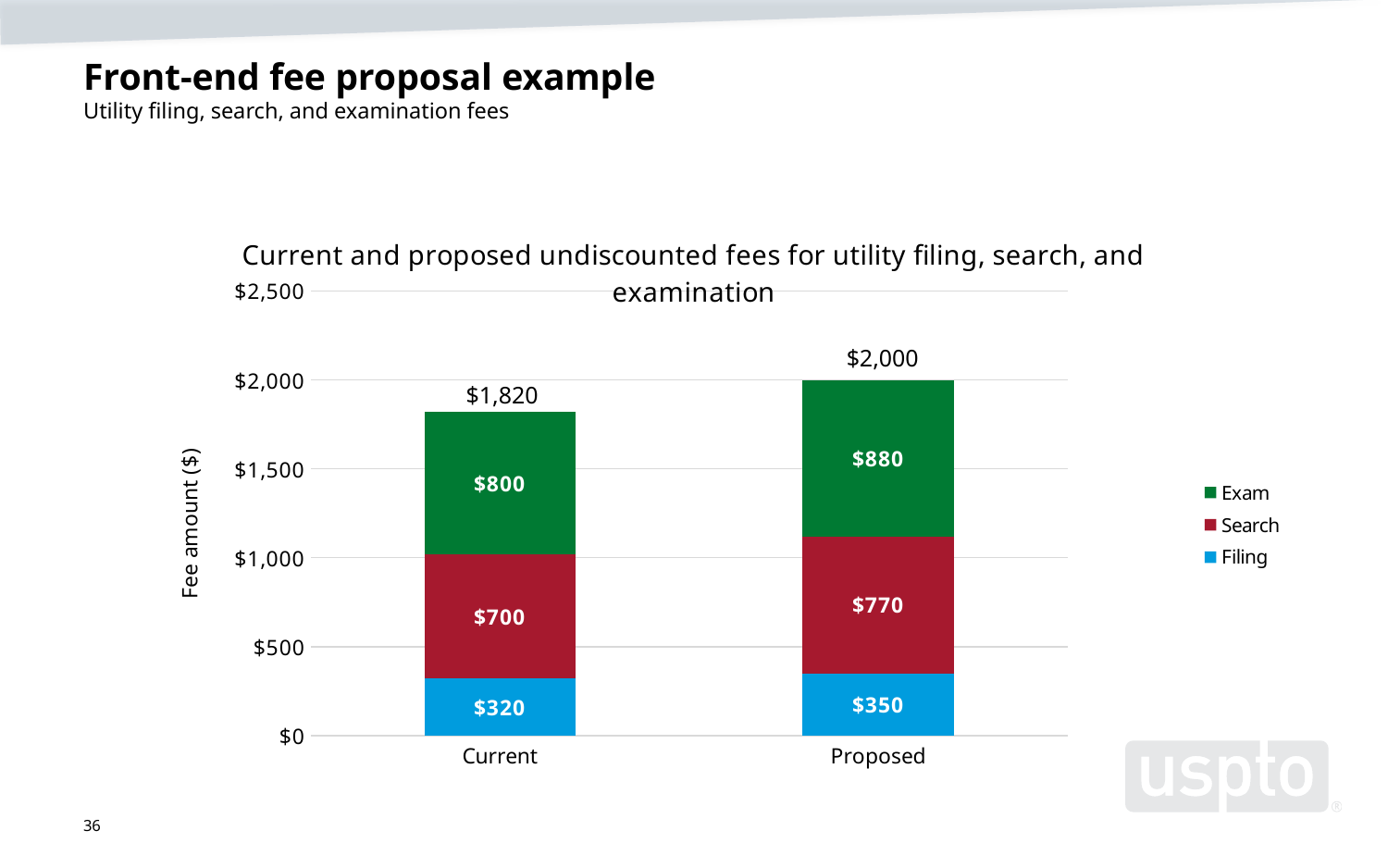
What is the Search fee for the Proposed bar? $770 What is the difference between the Proposed and Current totals? $180 How many series does the legend list? 3 Which is larger, the Current Filing fee or the Proposed Filing fee? Proposed Filing fee What is the difference between the Proposed and Current Exam fees? $80 What is the Exam fee for the Current bar? $800 What kind of chart is shown on the slide? Stacked bar chart What is the Filing fee for the Current bar? $320 What is the total of the Proposed stacked bar? $2,000 Which category has the higher total fee, Current or Proposed? Proposed What is the label of the y axis? Fee amount ($) What is the total of the Current stacked bar? $1,820